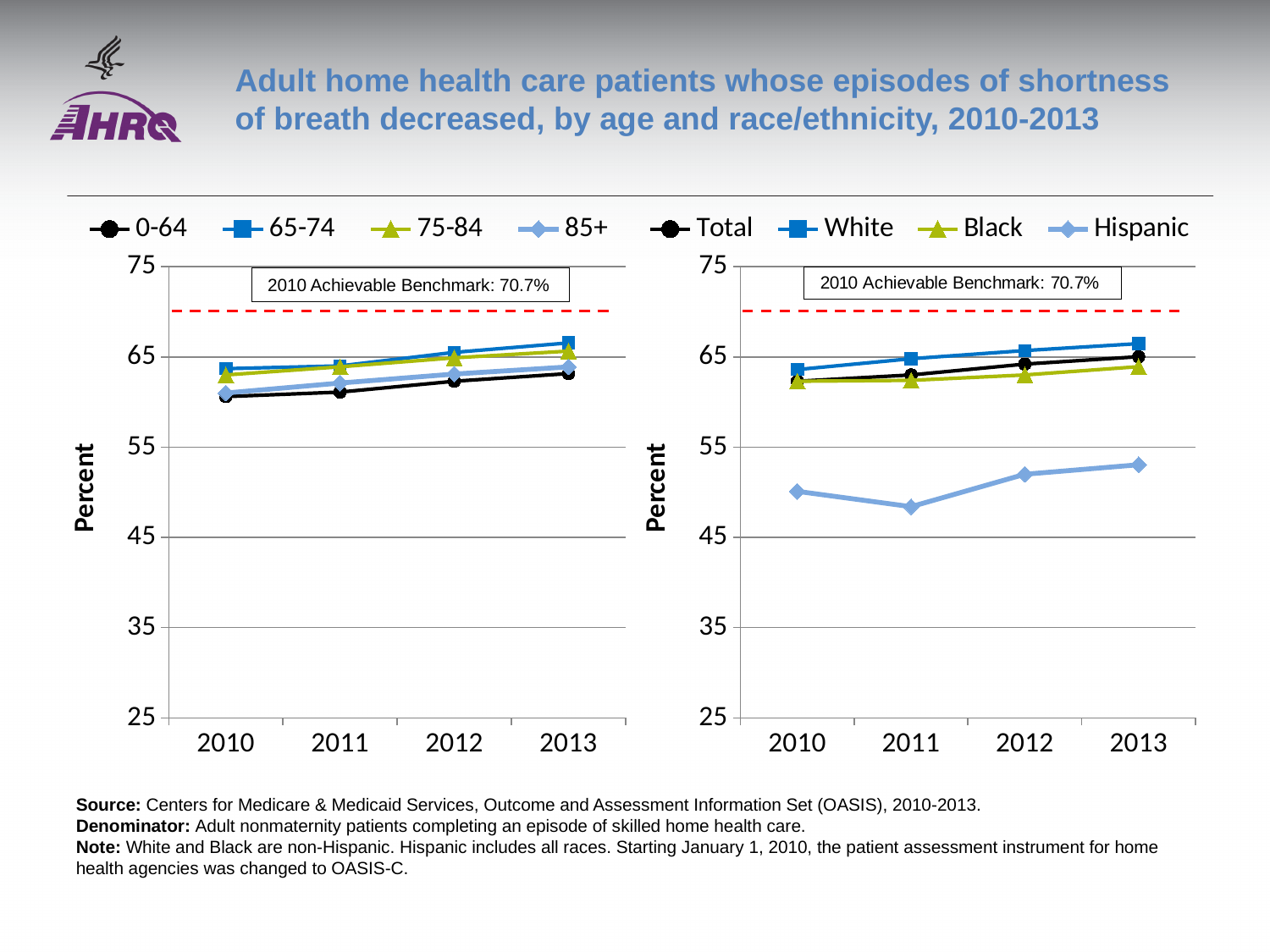
In the left chart (by age), is the value for 65-74 in 2013 greater or less than 65? greater In the left chart (by age), do the values for 65-74 rise or fall from 2010 to 2013? rise In the right chart (by race/ethnicity), which group has the lowest values across all years? Hispanic In the right chart (by race/ethnicity), which is larger in 2013, White or Hispanic? White In the left chart (by age), is the value for 0-64 in 2010 greater or less than 65? less How many years are shown on the x axis of the left chart (by age)? 4 What is the 2010 Achievable Benchmark shown on the charts? 70.7% In the right chart (by race/ethnicity), is the value for Hispanic in 2010 greater or less than 55? less How many series does the legend of the right chart (by race/ethnicity) list? 4 What kind of chart is the left chart (by age)? line chart In the right chart (by race/ethnicity), which group has the highest value in 2013? White